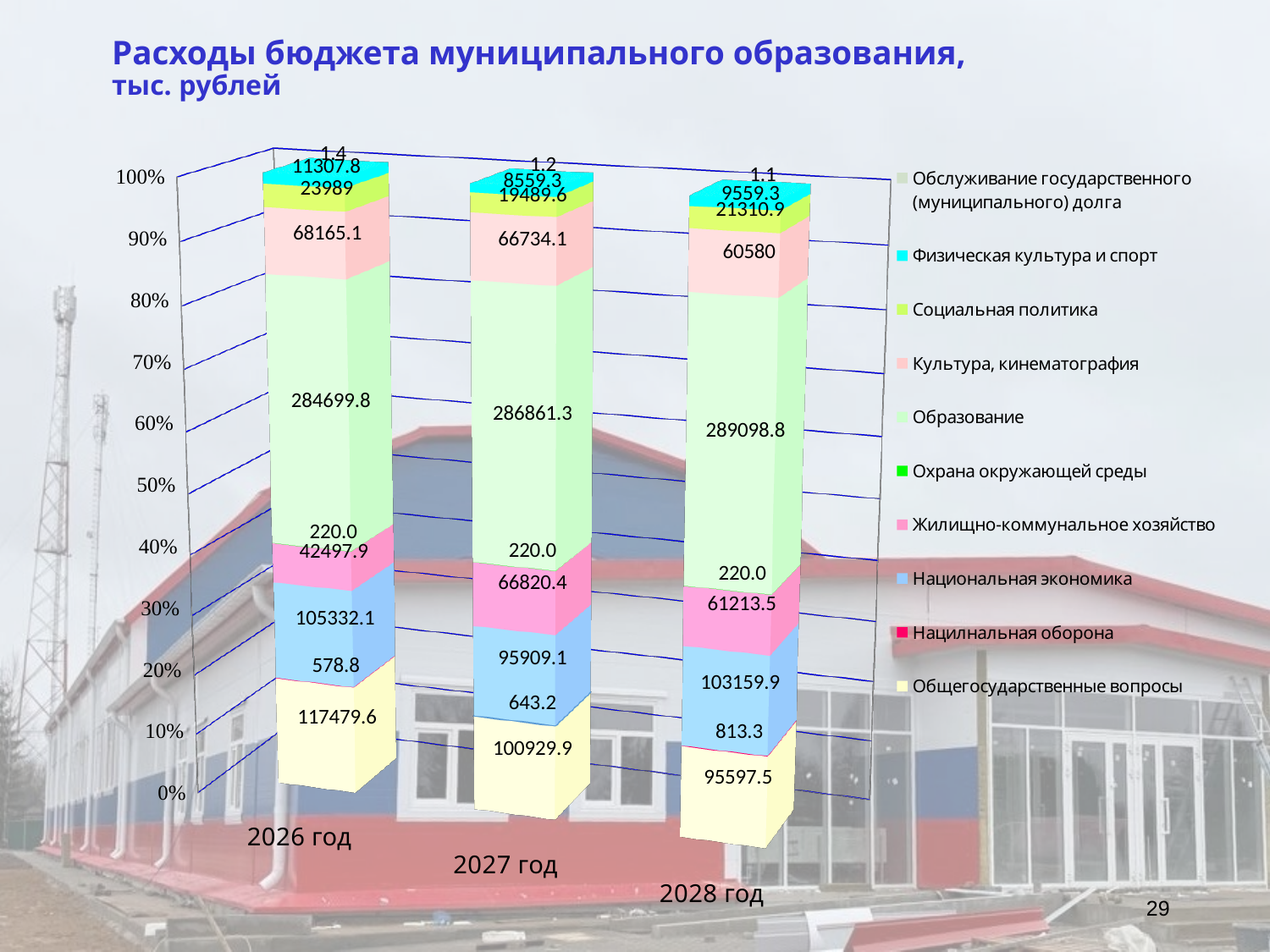
What is the value for Жилищно-коммунальное хозяйство in 2028 год? 61213.5 In which year is the value for Образование the highest? 2028 год What is the value for Образование in 2027 год? 286861.3 In which year is the value for Общегосударственные вопросы the lowest? 2028 год What is the value for Общегосударственные вопросы in 2026 год? 117479.6 What is the difference between the Образование values for 2028 год and 2026 год? 4399.0 What is the value for Физическая культура и спорт in 2026 год? 11307.8 How many series does the legend list? 10 Which is larger: Национальная экономика in 2026 год or in 2027 год? 2026 год How many years are shown on the x axis? 3 Do the values for Общегосударственные вопросы rise or fall from 2026 год to 2028 год? Fall What kind of chart is shown on the slide? Stacked bar chart